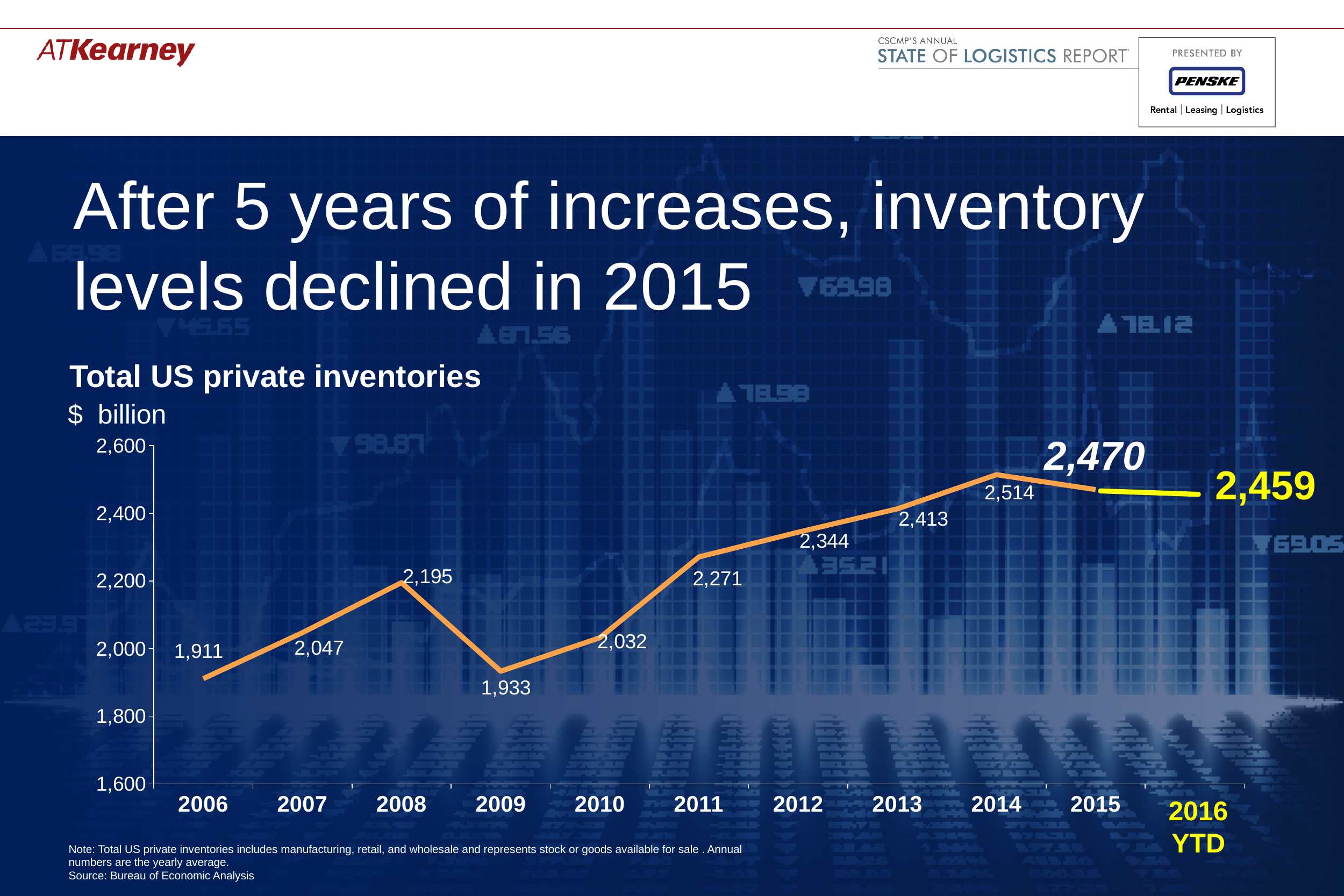
What is the value for 2016 YTD in the Total US private inventories chart? 2,459 What is the value for 2015 in the Total US private inventories chart? 2,470 Which is larger in the Total US private inventories chart, the value for 2008 or the value for 2010? 2008 What is the value for 2014 in the Total US private inventories chart? 2,514 What is the value for 2009 in the Total US private inventories chart? 1,933 What kind of chart is used to show Total US private inventories? Line chart Which year has the lowest value in the Total US private inventories chart? 2006 Which year has the highest value in the Total US private inventories chart? 2014 How many data points are plotted in the Total US private inventories chart? 11 What is the difference between the 2014 and 2015 values in the Total US private inventories chart? 44 What is the difference between the 2008 and 2009 values in the Total US private inventories chart? 262 What unit is shown for the values in the Total US private inventories chart? $ billion